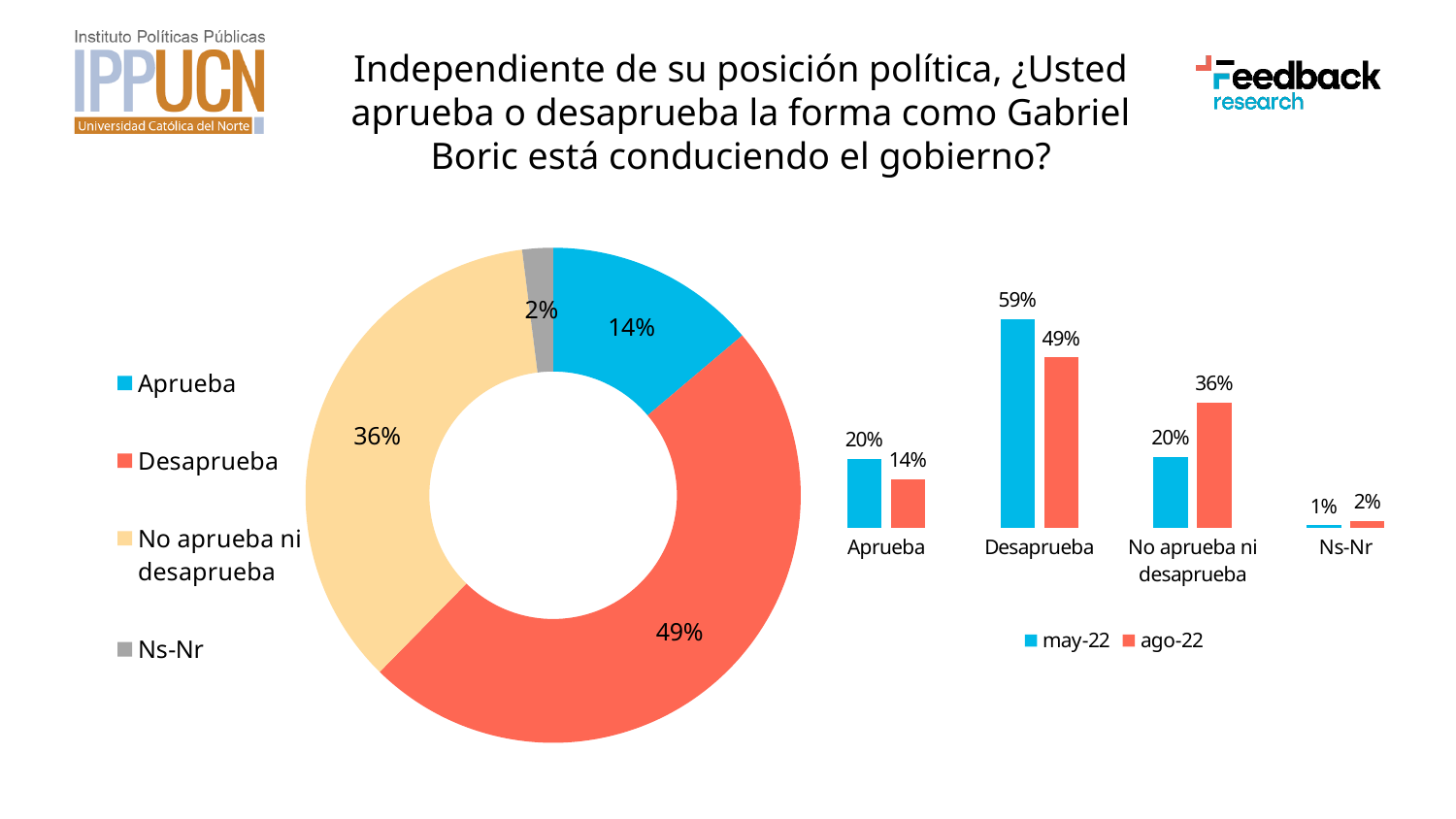
What kind of chart is shown on the right side of the slide? Bar chart In the doughnut chart on the left, what share is shown for No aprueba ni desaprueba? 36% In the bar chart on the right, what is the value for No aprueba ni desaprueba in ago-22? 36% In the doughnut chart on the left, how many categories does the legend list? 4 In the doughnut chart on the left, which category has the largest share? Desaprueba In the doughnut chart on the left, which category has the smallest share? Ns-Nr In the bar chart on the right, what colour represents the ago-22 series? Red/orange In the bar chart on the right, how many series does the legend list? 2 In the bar chart on the right, what is the value for Desaprueba in may-22? 59% In the doughnut chart on the left, what share is shown for Desaprueba? 49% In the bar chart on the right, what is the difference between the may-22 and ago-22 values for Desaprueba? 10% In the bar chart on the right, which is larger for Aprueba: the may-22 value or the ago-22 value? may-22